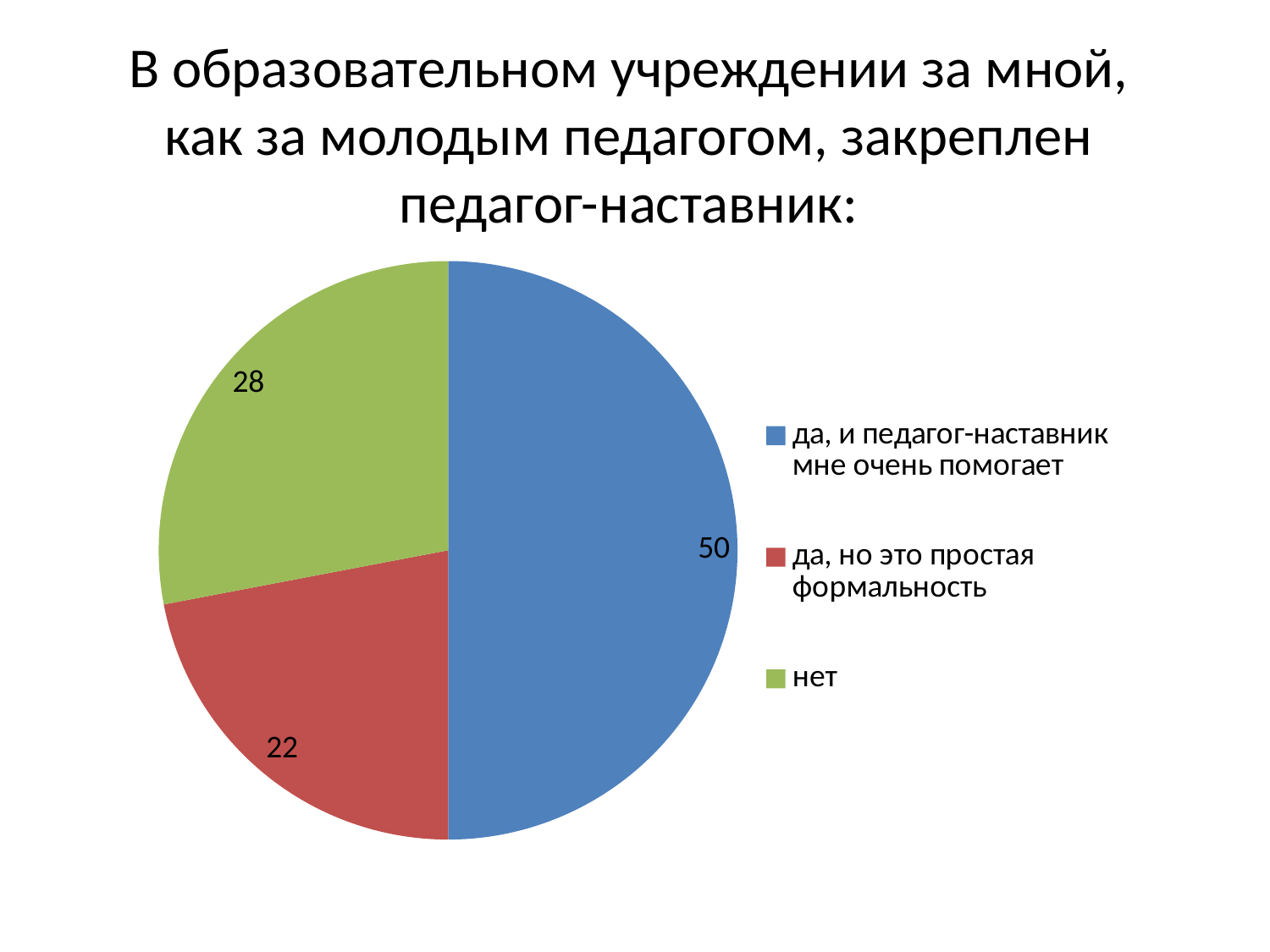
Which category has the largest slice? да, и педагог-наставник мне очень помогает What kind of chart is shown on the slide? pie chart What is the value for "нет"? 28 What is the difference between the values for "да, и педагог-наставник мне очень помогает" and "нет"? 22 What is the value for "да, но это простая формальность"? 22 How many slices does the pie chart have? 3 Which is larger: the value for "нет" or the value for "да, но это простая формальность"? нет What colour is the slice for "нет"? green What is the value for "да, и педагог-наставник мне очень помогает"? 50 What share of the pie does "да, и педагог-наставник мне очень помогает" represent? 50% Which category has the smallest slice? да, но это простая формальность What is the difference between the values for "нет" and "да, но это простая формальность"? 6